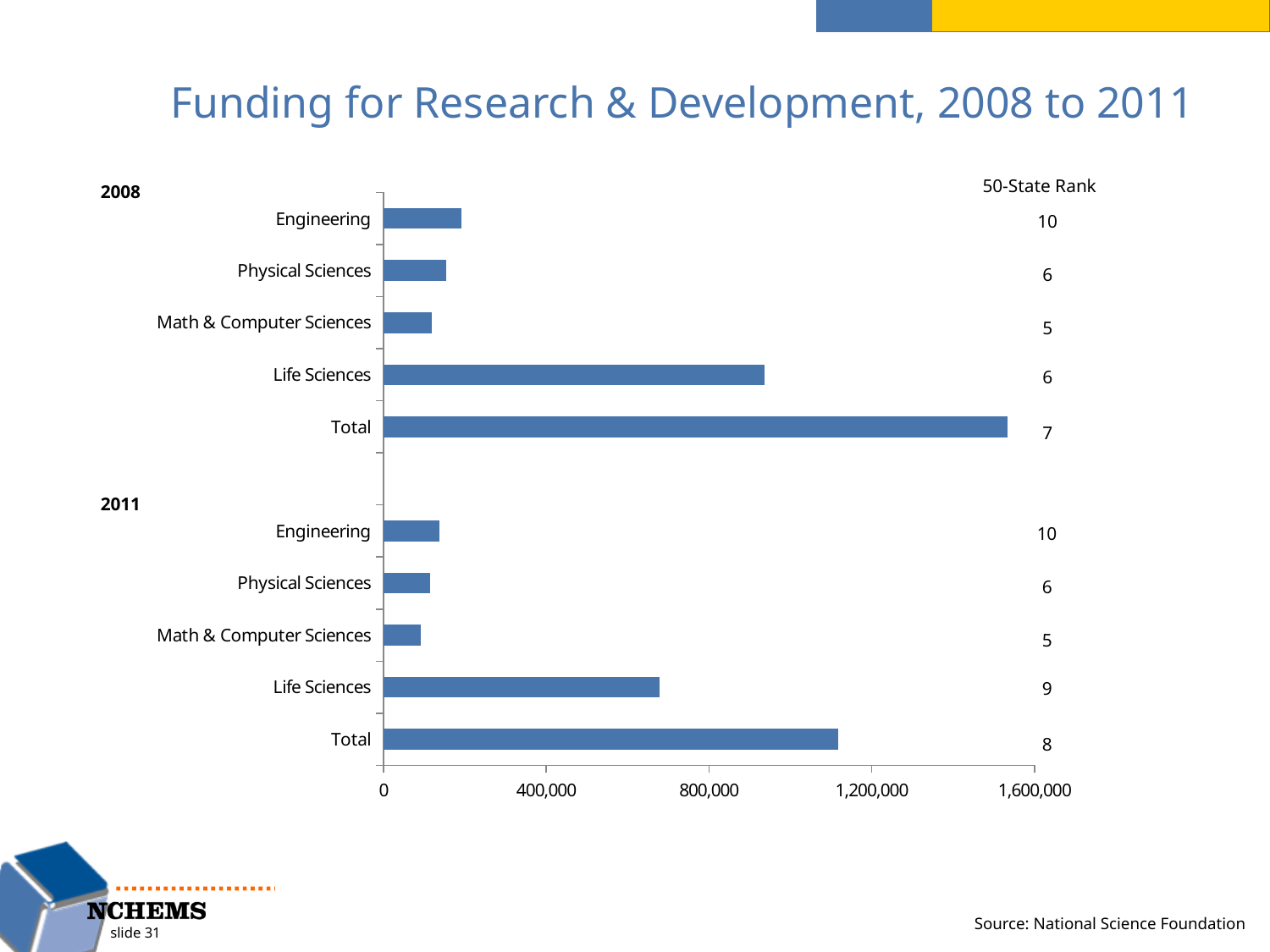
Is the 2011 Life Sciences funding value greater or less than 800,000? less What is the title of the chart? Funding for Research & Development, 2008 to 2011 Excluding Total, which field has the highest funding in 2011? Life Sciences Which category has the longest bar in the 2008 group? Total Is the 2008 Engineering funding value greater or less than 400,000? less Did Life Sciences funding rise or fall from 2008 to 2011? fall What kind of chart is shown on the slide? bar chart What is the 50-State Rank shown for Life Sciences in 2011? 9 Which is larger, the Total funding in 2008 or the Total funding in 2011? 2008 Which field has the shortest bar in the 2011 group? Math & Computer Sciences How many bars are plotted in the 2011 group? 5 Is the 2008 Total funding value greater or less than 1,200,000? greater